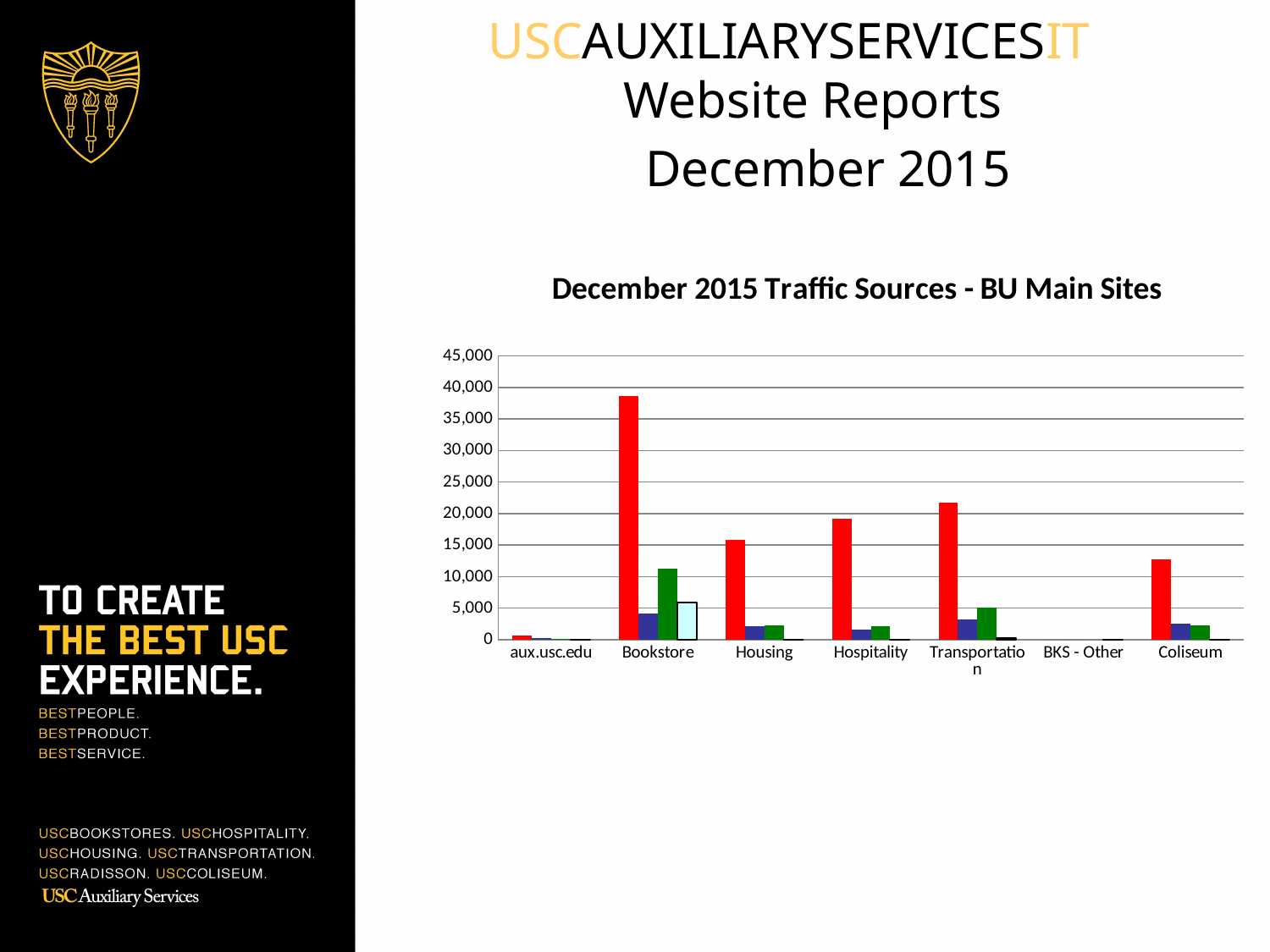
Is the red bar for Transportation greater or less than 20,000? greater Is the red bar for Hospitality greater or less than 20,000? less Is the red bar for Bookstore greater or less than 35,000? greater What is the title of the chart? December 2015 Traffic Sources - BU Main Sites Which has the larger red bar, Housing or Coliseum? Housing How many categories are shown along the x axis of the chart? 7 Which has the larger red bar, Transportation or Hospitality? Transportation What kind of chart is shown on the slide? bar chart Which category has the tallest red bar? Bookstore